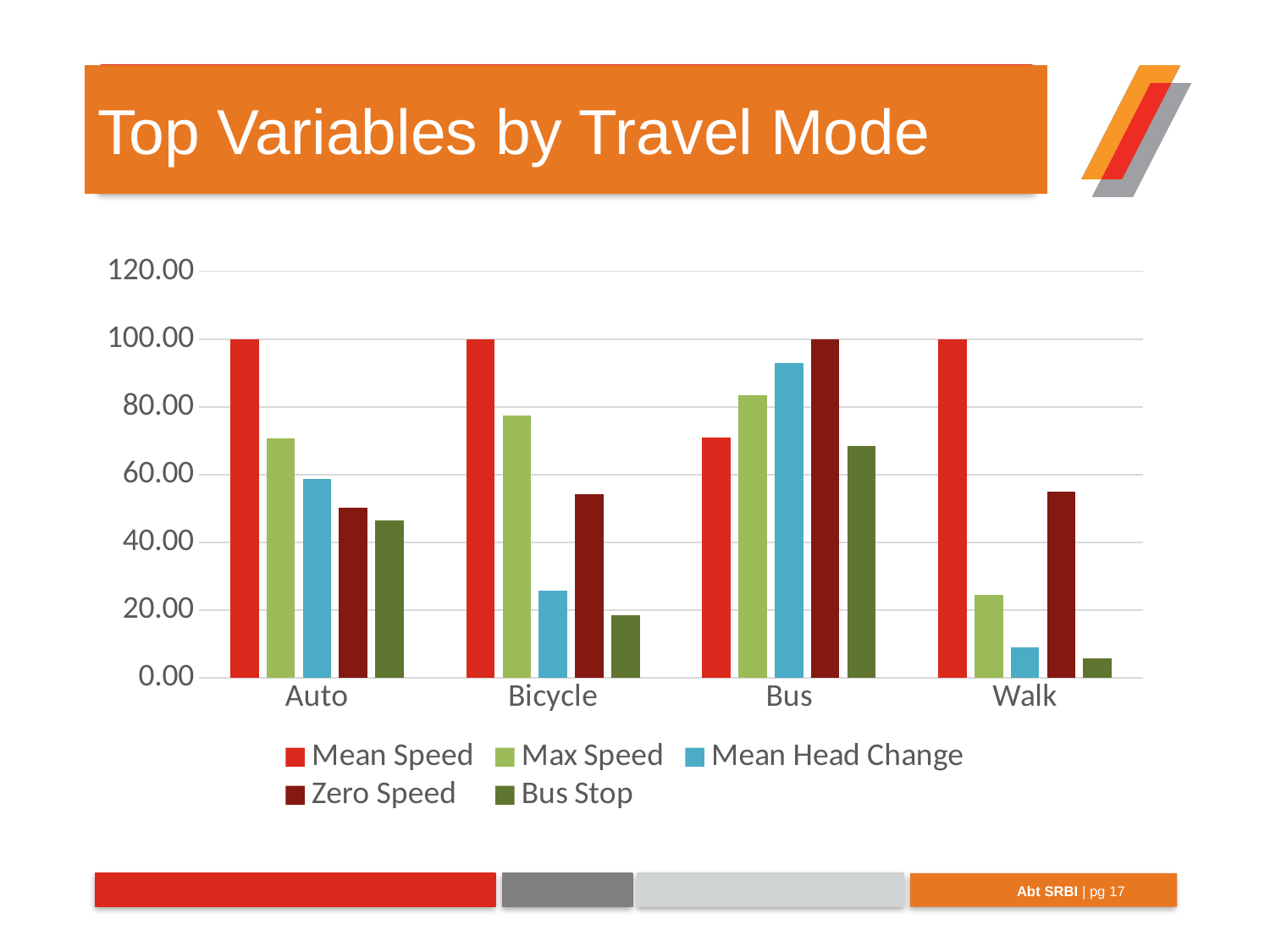
What is the Zero Speed value for Bus? 100.00 Which travel mode has the lowest Mean Speed value? Bus What is the Mean Speed value for Auto? 100.00 How many travel mode categories are shown on the x axis? 4 What type of chart is shown on the slide? bar chart Which series has the lowest value for Walk? Bus Stop Is the Mean Head Change value for Bus greater or less than 80.00? greater Which is larger, the Mean Head Change value for Bus or for Bicycle? Bus Which series has the highest value for Bus? Zero Speed How many series does the legend list? 5 Is the Bus Stop value for Bicycle greater or less than 20.00? less Which travel mode has the highest Bus Stop value? Bus